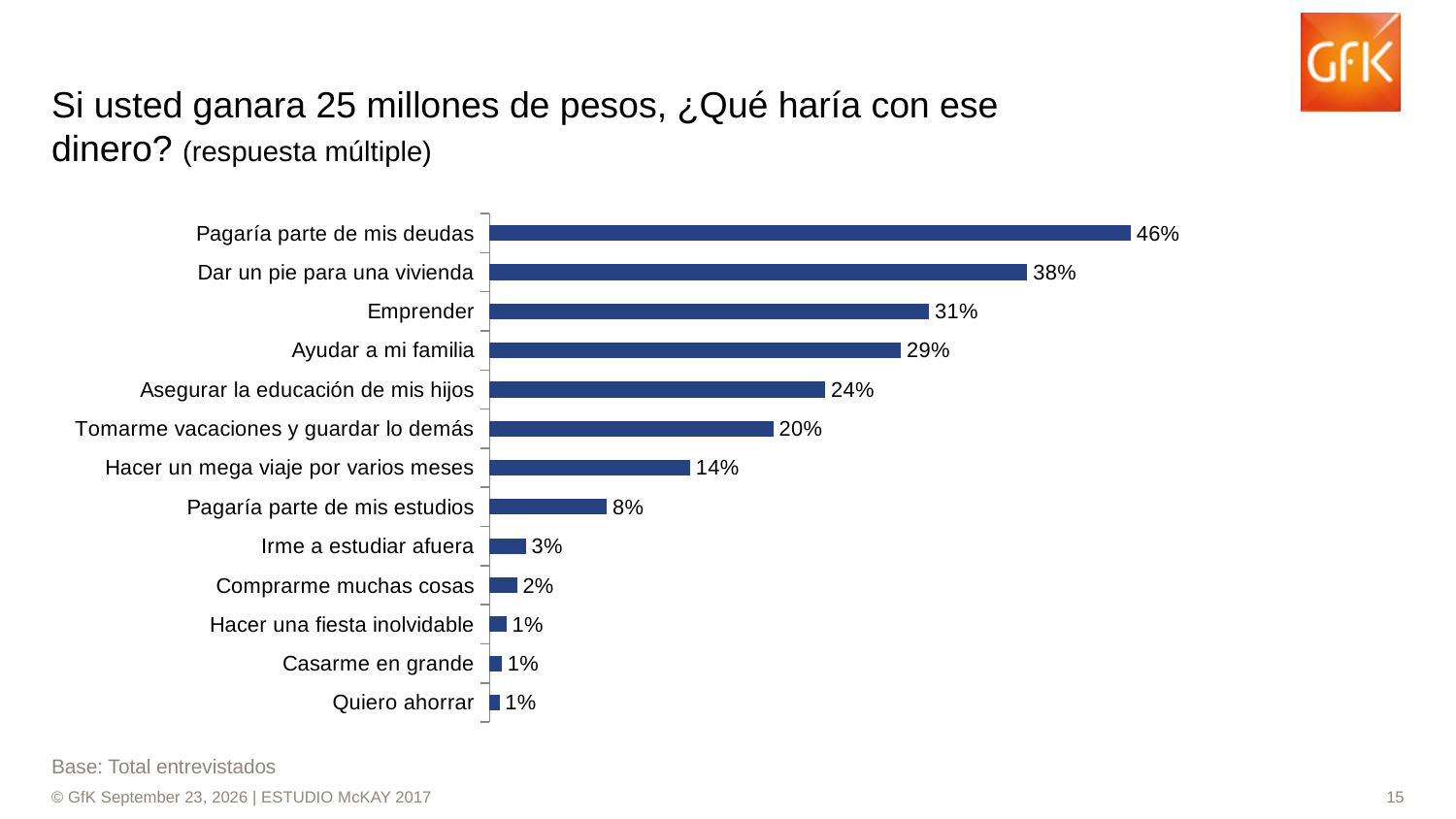
What is the difference between "Asegurar la educación de mis hijos" and "Pagaría parte de mis estudios"? 16% What is the difference between "Dar un pie para una vivienda" and "Ayudar a mi familia"? 9% What is the value for "Irme a estudiar afuera"? 3% Which category has the highest value? Pagaría parte de mis deudas Which is larger, "Tomarme vacaciones y guardar lo demás" or "Comprarme muchas cosas"? Tomarme vacaciones y guardar lo demás How many categories have a value of 1%? 3 What is the base noted below the chart? Total entrevistados What is the value for "Emprender"? 31% How many categories are shown in the chart? 13 What is the value for "Hacer un mega viaje por varios meses"? 14% What kind of chart is shown on the slide? Bar chart What is the value for "Pagaría parte de mis deudas"? 46%